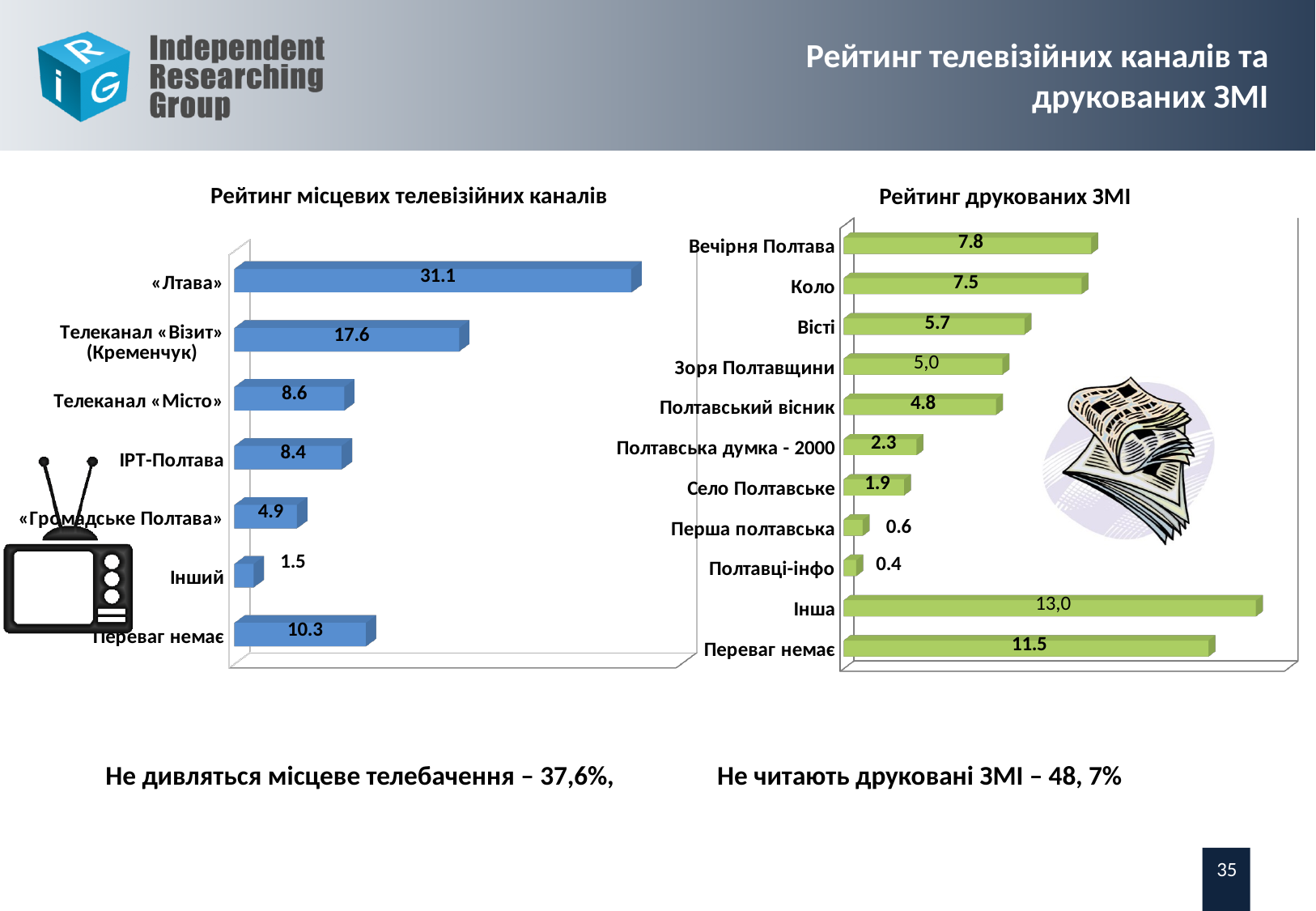
In the chart "Рейтинг друкованих ЗМІ", which is larger: Коло or Вісті? Коло In the chart "Рейтинг друкованих ЗМІ", which category has the highest value? Інша In the chart "Рейтинг друкованих ЗМІ", how many categories are shown? 11 In the chart "Рейтинг друкованих ЗМІ", what is the difference between Переваг немає and Полтавський вісник? 6.7 In the chart "Рейтинг місцевих телевізійних каналів", what is the difference between «Лтава» and Телеканал «Візит» (Кременчук)? 13.5 In the chart "Рейтинг друкованих ЗМІ", what is the value for Полтавці-інфо? 0.4 In the chart "Рейтинг місцевих телевізійних каналів", which category has the lowest value? Інший In the chart "Рейтинг місцевих телевізійних каналів", what is the value for «Лтава»? 31.1 In the chart "Рейтинг місцевих телевізійних каналів", what kind of chart is it? Bar chart In the chart "Рейтинг місцевих телевізійних каналів", how many categories are shown? 7 In the chart "Рейтинг друкованих ЗМІ", what is the value for Вечірня Полтава? 7.8 In the chart "Рейтинг місцевих телевізійних каналів", what is the value for Телеканал «Візит» (Кременчук)? 17.6